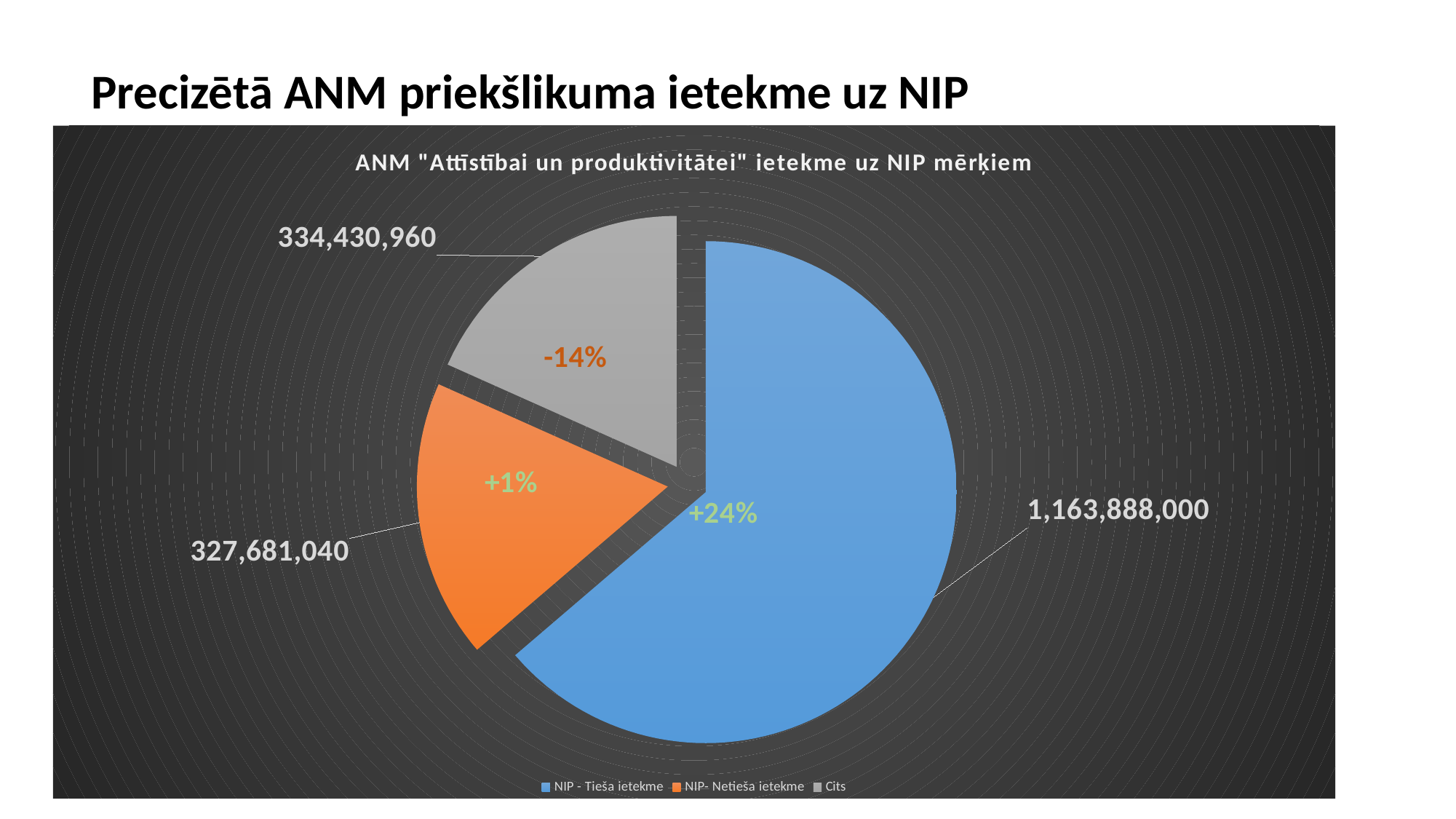
Which category has the largest slice of the pie? NIP - Tieša ietekme Which is larger, the value for Cits or the value for NIP- Netieša ietekme? Cits What percentage label is printed on the blue slice? +24% What type of chart is shown on the slide? Pie chart What is the value for Cits? 334,430,960 How many slices does the pie chart have? 3 What is the value for NIP- Netieša ietekme? 327,681,040 What is the value for NIP - Tieša ietekme? 1,163,888,000 What is the title of the chart? ANM "Attīstībai un produktivitātei" ietekme uz NIP mērķiem What is the difference between the values for Cits and NIP- Netieša ietekme? 6,749,920 What is the difference between the values for NIP - Tieša ietekme and NIP- Netieša ietekme? 836,206,960 Which category has the smallest value? NIP- Netieša ietekme